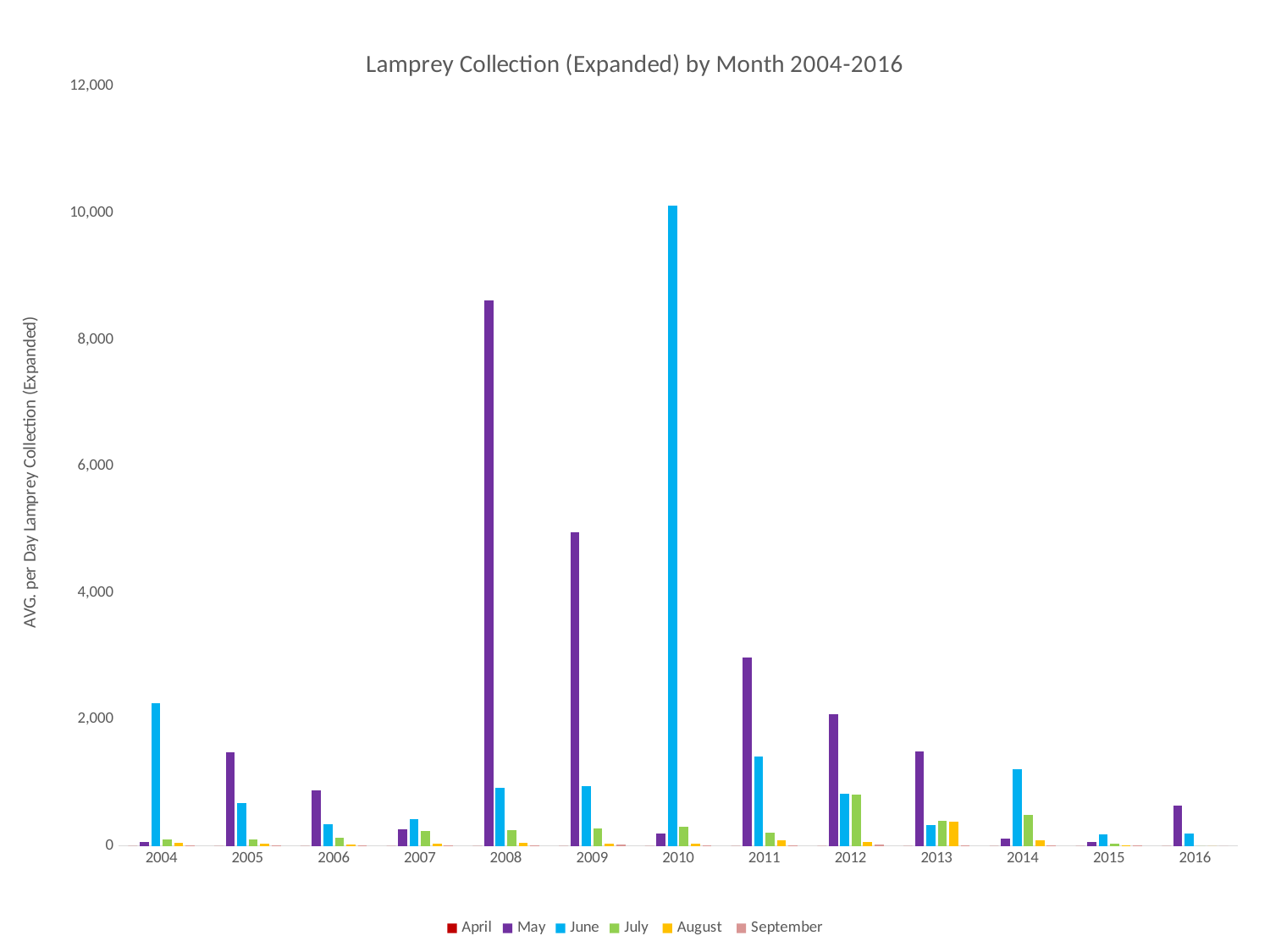
What kind of chart is shown on the slide? bar chart How many series does the legend list? 6 In 2011, which is larger, the May value or the June value? May In which year is the June bar the highest? 2010 Is the value for May in 2011 greater or less than 2,000? greater Is the value for June in 2010 greater or less than 8,000? greater In which year is the May bar the highest? 2008 Is the value for May in 2009 greater or less than 4,000? greater How many years are shown along the x axis? 13 In 2004, which is larger, the June value or the May value? June What is the title of the y axis? AVG. per Day Lamprey Collection (Expanded)